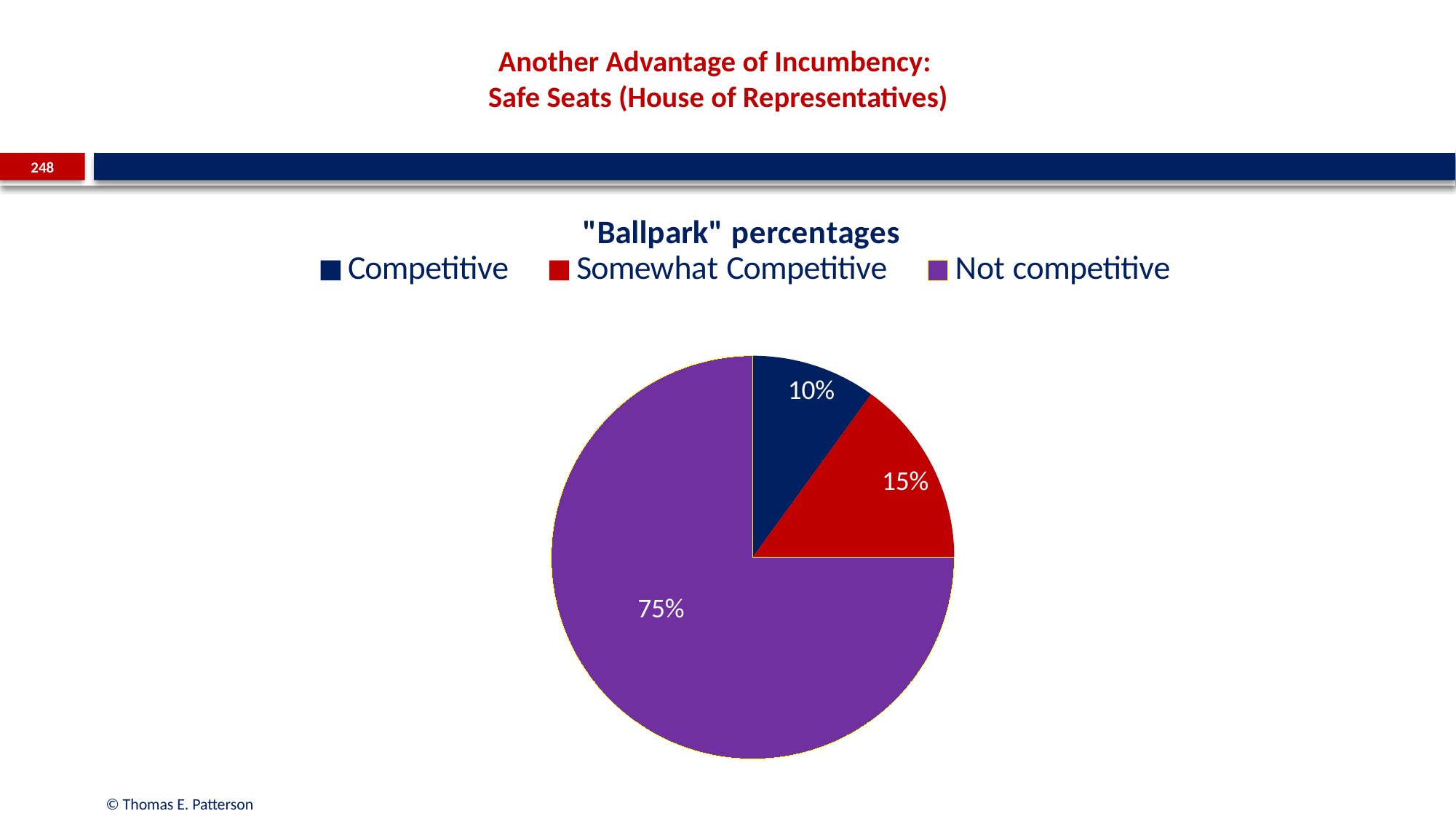
Which category has the largest slice of the pie? Not competitive What is the difference in percentage points between the Not competitive slice and the Somewhat Competitive slice? 60 What percentage of the pie is labelled for Somewhat Competitive? 15% Which slice is larger, Competitive or Somewhat Competitive? Somewhat Competitive What is the title of the chart? "Ballpark" percentages What is the difference in percentage points between the Somewhat Competitive slice and the Competitive slice? 5 What percentage of the pie is labelled for Competitive? 10% How many slices does the pie chart have? 3 What kind of chart is shown on the slide? pie chart Which category has the smallest slice of the pie? Competitive What percentage of the pie is labelled for Not competitive? 75% What colour is the Not competitive slice in the pie chart? purple